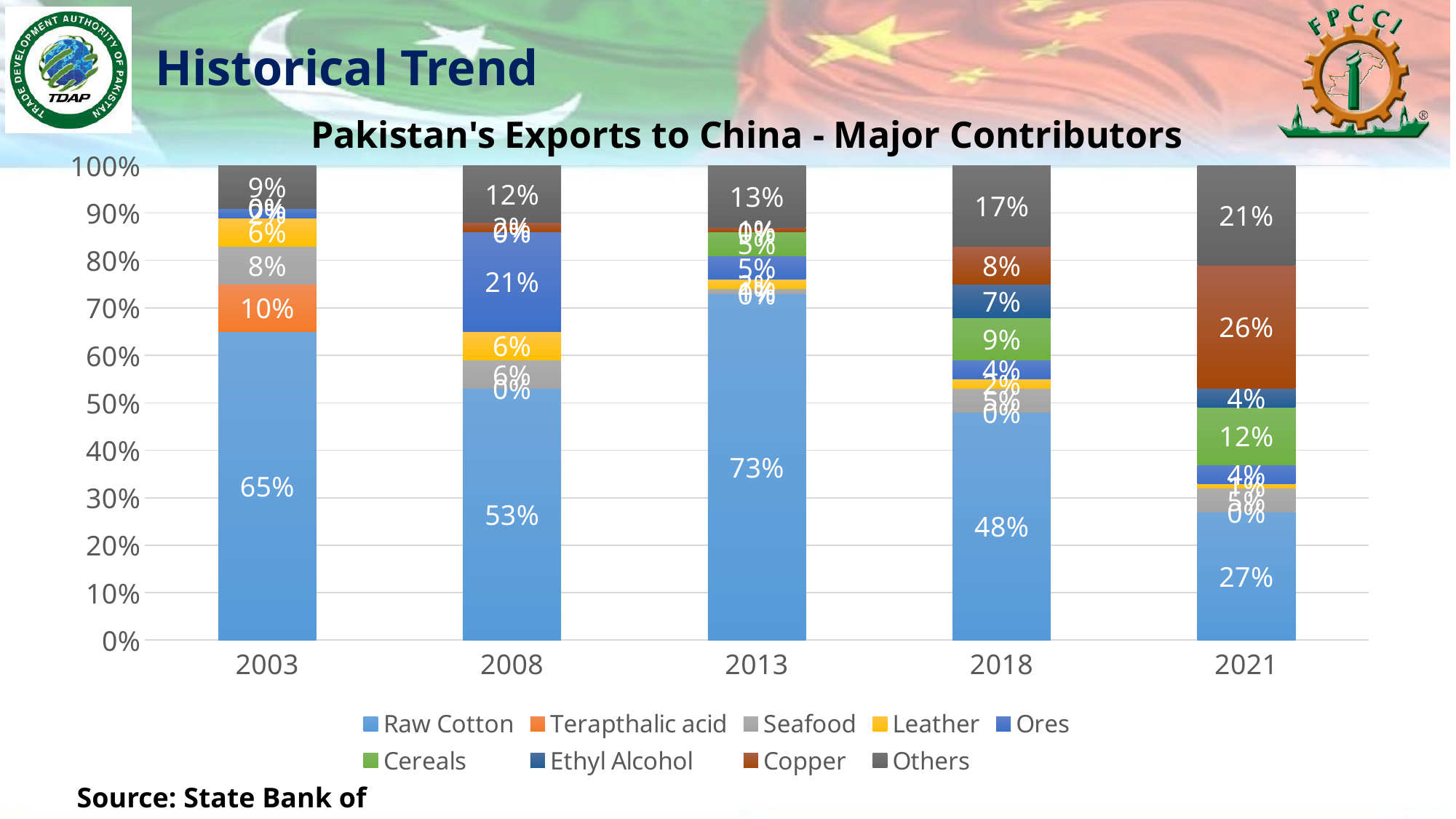
What share did Terapthalic acid account for in 2003? 10% What share of Pakistan's exports to China was Raw Cotton in 2013? 73% Which is larger in 2021, the Copper share or the Cereals share? Copper How many series does the legend list? 9 What share did Raw Cotton account for in 2021? 27% How does the Others share change from 2003 to 2021? It rises In which year was the Raw Cotton share lowest? 2021 What is the value for Ores in 2008? 21% What share did Copper contribute in 2021? 26% By how many percentage points did the Raw Cotton share fall from 2013 to 2021? 46 percentage points What is the value for Others in 2018? 17% In which year was the Raw Cotton share highest? 2013